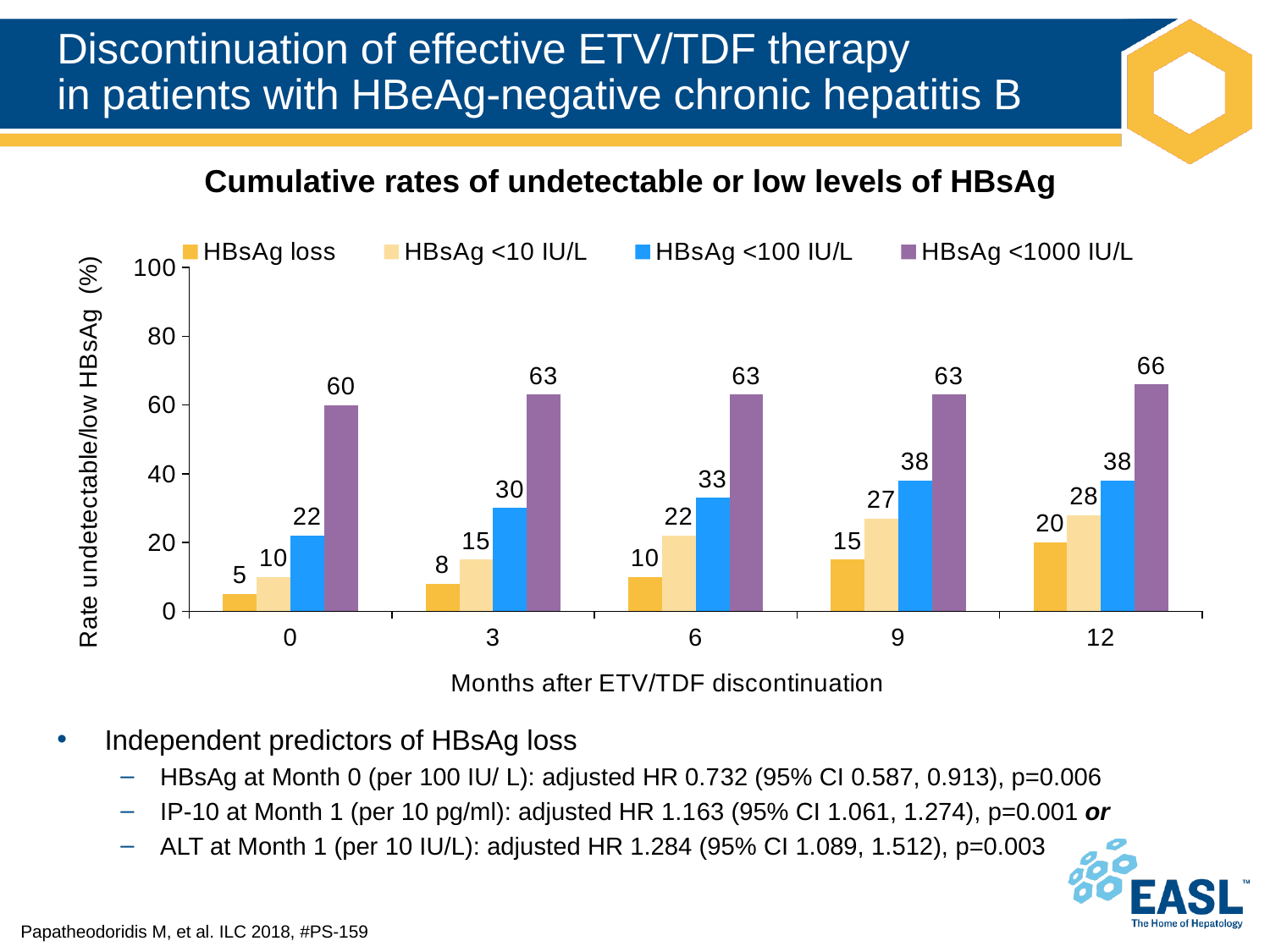
How many time points are shown on the x axis? 5 What is the difference between the HBsAg <100 IU/L values at month 12 and month 0? 16 At which month is the HBsAg loss value lowest? 0 What is the value for HBsAg loss at month 0? 5 Which is larger: HBsAg <10 IU/L at month 6 or HBsAg <10 IU/L at month 12? HBsAg <10 IU/L at month 12 What kind of chart is shown? Bar chart What is the value for HBsAg <100 IU/L at month 12? 38 How many series does the legend list? 4 At which month is the HBsAg <1000 IU/L value highest? 12 What is the value for HBsAg <1000 IU/L at month 3? 63 What is the value for HBsAg <10 IU/L at month 9? 27 Does the HBsAg loss value rise or fall from month 0 to month 12? Rise